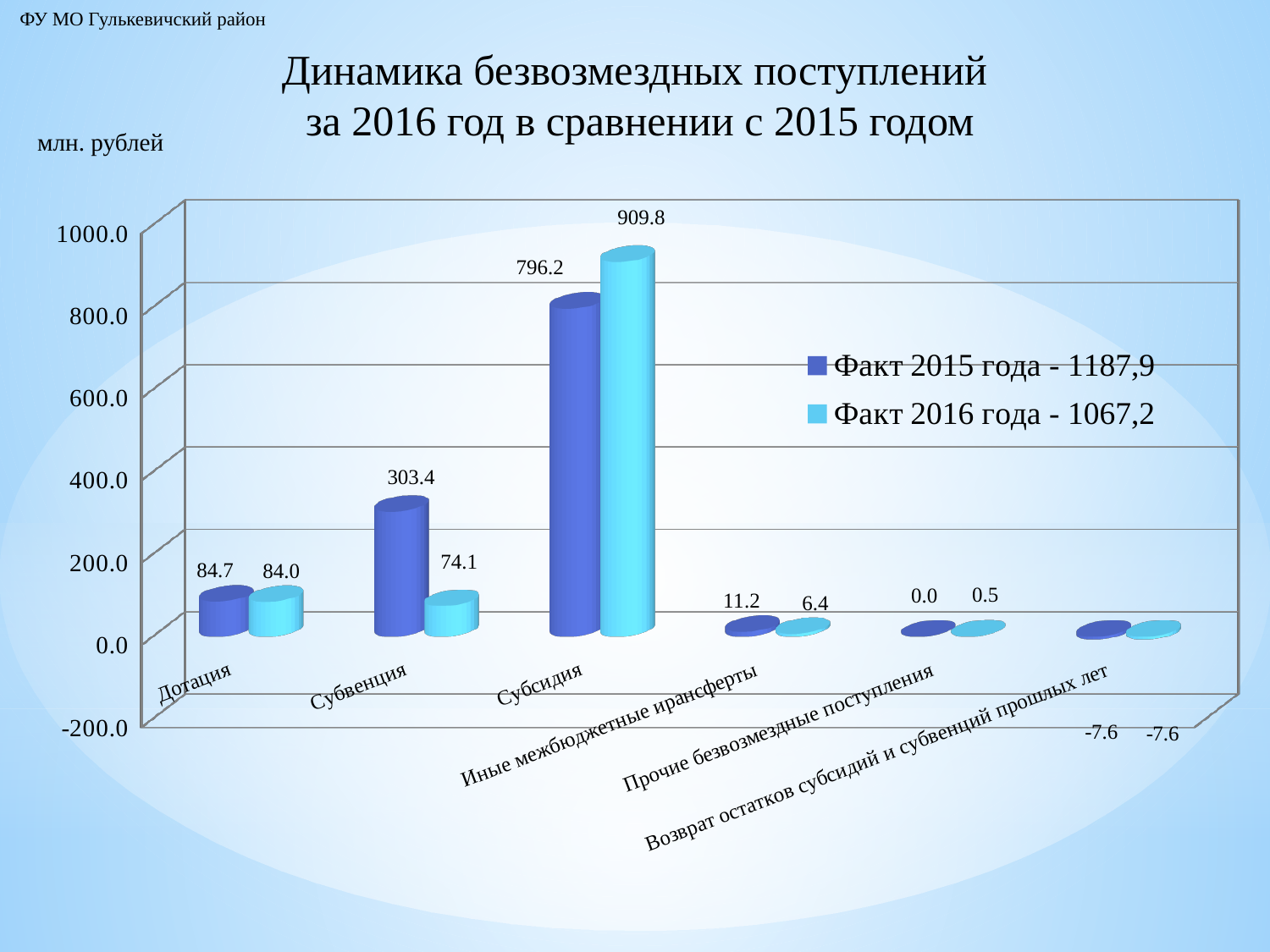
What is the value for Субсидия in the series Факт 2016 года? 909.8 Which category has the lowest value in the series Факт 2016 года? Возврат остатков субсидий и субвенций прошлых лет What is the difference between the Факт 2015 года and Факт 2016 года values for Субвенция? 229.3 For Дотация, which series has the larger value, Факт 2015 года or Факт 2016 года? Факт 2015 года How many series does the legend list? 2 What is the value for Иные межбюджетные трансферты in the series Факт 2016 года? 6.4 How many categories are shown on the x axis? 6 Which category has the highest value in the series Факт 2015 года? Субсидия What is the value for Субвенция in the series Факт 2015 года? 303.4 What is the value for Возврат остатков субсидий и субвенций прошлых лет in the series Факт 2015 года? -7.6 What is the difference between the Факт 2016 года and Факт 2015 года values for Субсидия? 113.6 What kind of chart is shown on the slide? Bar chart